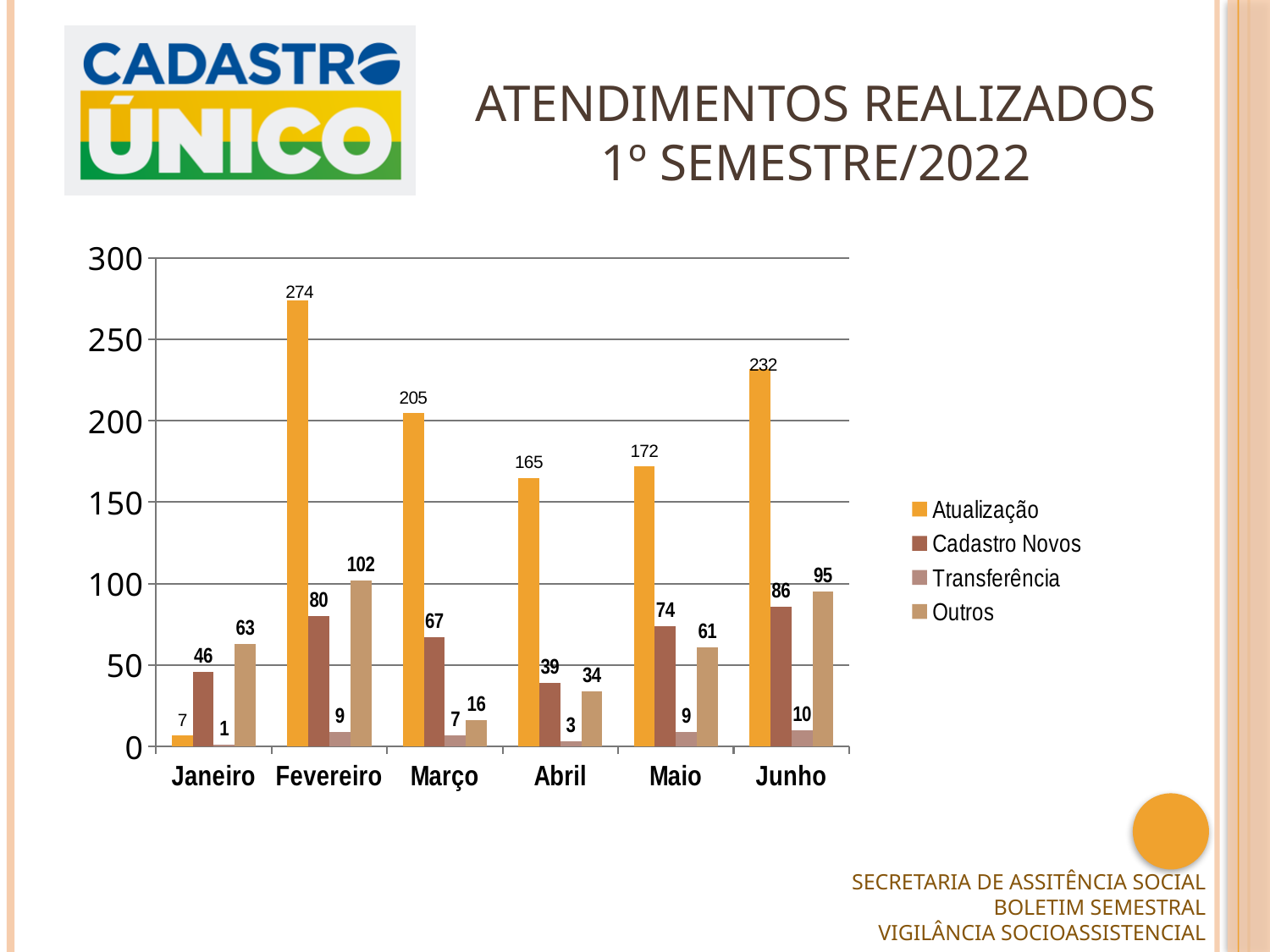
Which is larger, Outros for Maio or Outros for Janeiro? Outros for Janeiro Which month has the highest Atualização value? Fevereiro What is the value of Transferência for Abril? 3 What is the value of Outros for Março? 16 What kind of chart is shown on the slide? Bar chart What is the value of Atualização for Fevereiro? 274 What is the title of the slide's chart? ATENDIMENTOS REALIZADOS 1º SEMESTRE/2022 How many series does the legend list? 4 What is the difference between the Atualização values for Fevereiro and Junho? 42 How many months are shown on the x axis? 6 Which month has the lowest Cadastro Novos value? Abril What is the value of Cadastro Novos for Junho? 86